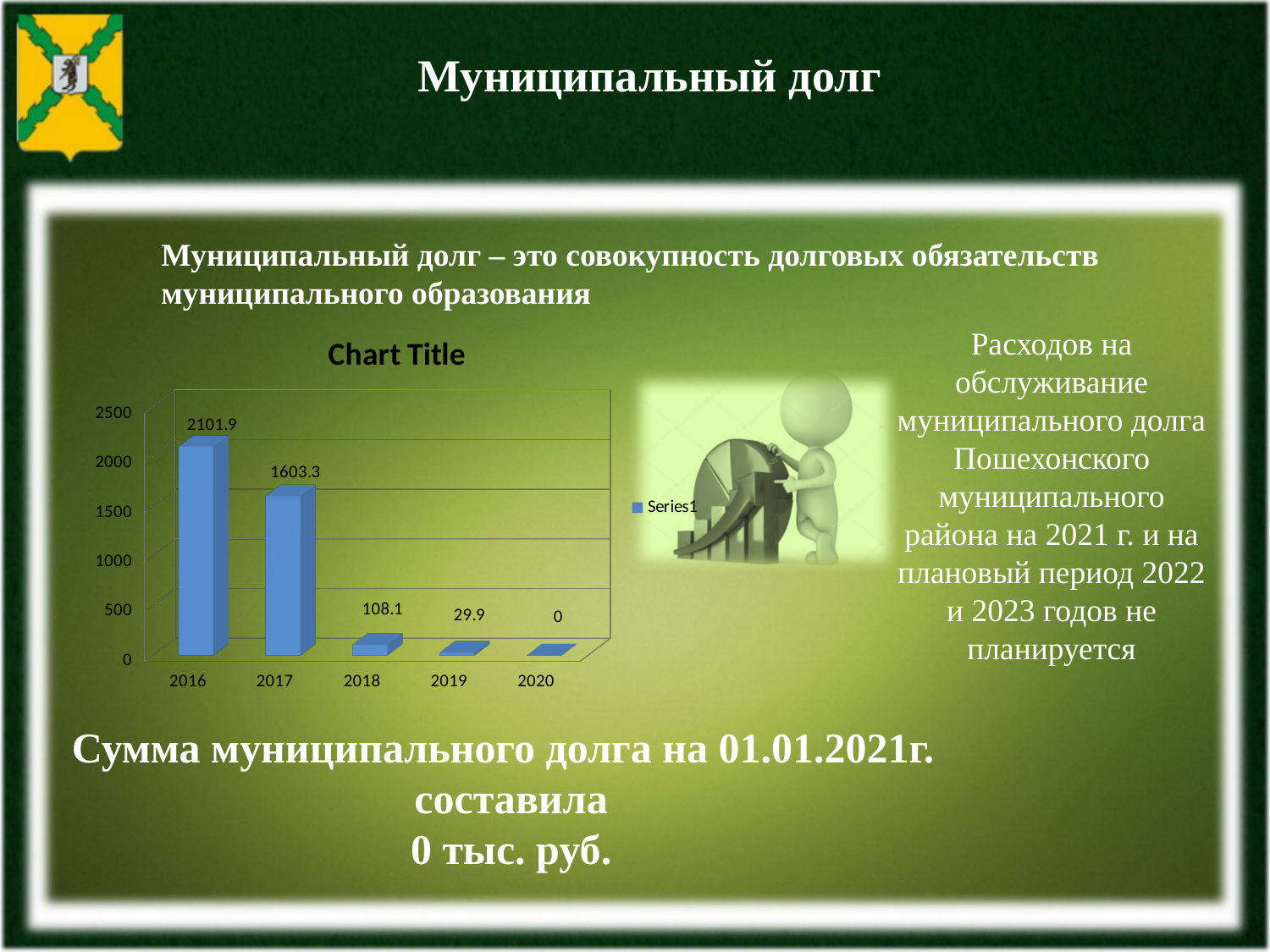
Which year has the lowest value? 2020 What is the value for 2016? 2101.9 What kind of chart is shown? bar chart What is the value for 2018? 108.1 Which is larger, the value for 2018 or the value for 2019? 2018 What is the value for 2017? 1603.3 What is the value for 2019? 29.9 What is the difference between the values for 2016 and 2017? 498.6 Which year has the highest value? 2016 Do the values rise or fall from 2016 to 2020? fall How many years are shown on the x axis? 5 What is the value for 2020? 0